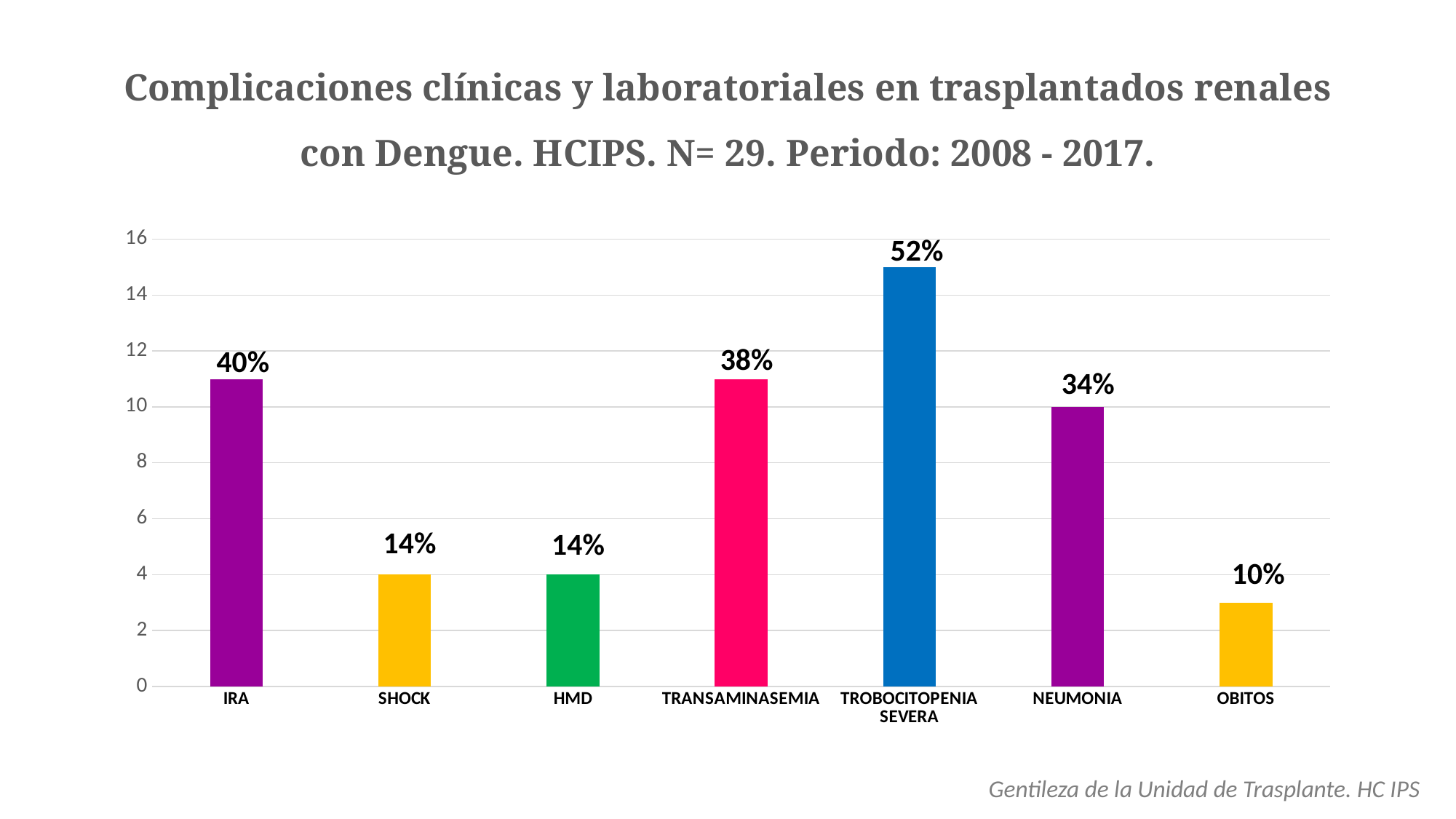
What is the value shown for SHOCK? 14% What is the value shown for TROBOCITOPENIA SEVERA? 52% Which category has the highest value? TROBOCITOPENIA SEVERA Is the bar for NEUMONIA greater or less than 8 on the vertical axis? greater Which category has the lowest value? OBITOS What is the value shown for OBITOS? 10% Which has a larger value, IRA or TRANSAMINASEMIA? IRA What type of chart is shown on the slide? Bar chart What is the difference between the values for TROBOCITOPENIA SEVERA and NEUMONIA? 18 percentage points How many categories are shown on the x axis? 7 What is the value shown for IRA? 40% Is the bar for OBITOS greater or less than 4 on the vertical axis? less